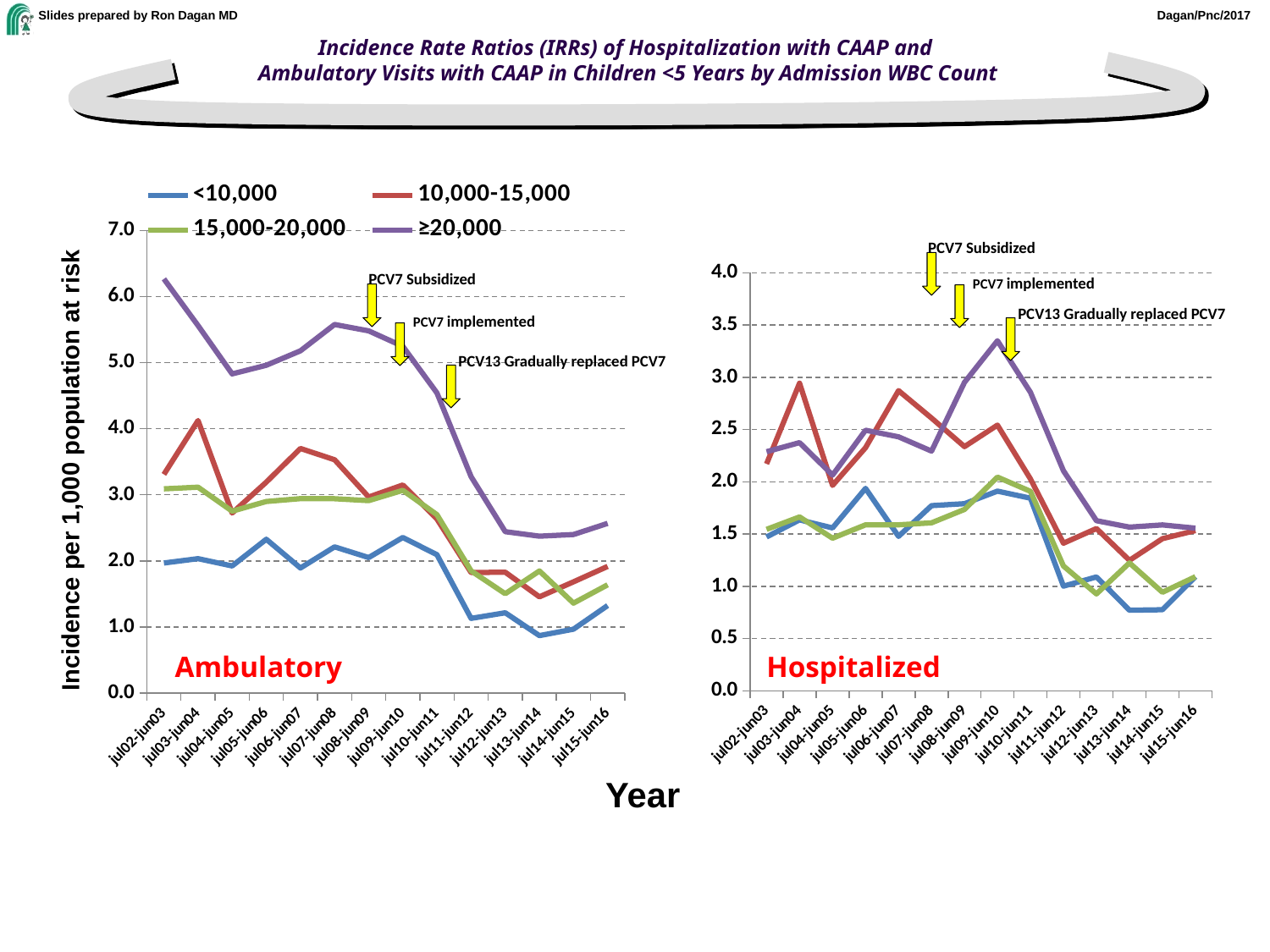
In the Ambulatory chart, is the value for the <10,000 series at jul13-jun14 greater or less than 1.0? less In the Hospitalized chart, is the value for the ≥20,000 series at jul09-jun10 greater or less than 3.0? greater In the Ambulatory chart, does the ≥20,000 series rise or fall from jul09-jun10 to jul12-jun13? fall In the Hospitalized chart, which series has the highest value at jul09-jun10? ≥20,000 What is the label on the shared y axis of the charts? Incidence per 1,000 population at risk What kind of chart is the Ambulatory chart on the left? line chart In the Ambulatory chart, which series has the highest value at jul02-jun03? ≥20,000 How many year categories are shown on the x axis of the Hospitalized chart? 14 In the Ambulatory chart, is the value for the ≥20,000 series at jul02-jun03 greater or less than 6.0? greater How many series does the legend list for the charts? 4 In the Ambulatory chart, which is larger at jul02-jun03: the ≥20,000 series or the 10,000-15,000 series? ≥20,000